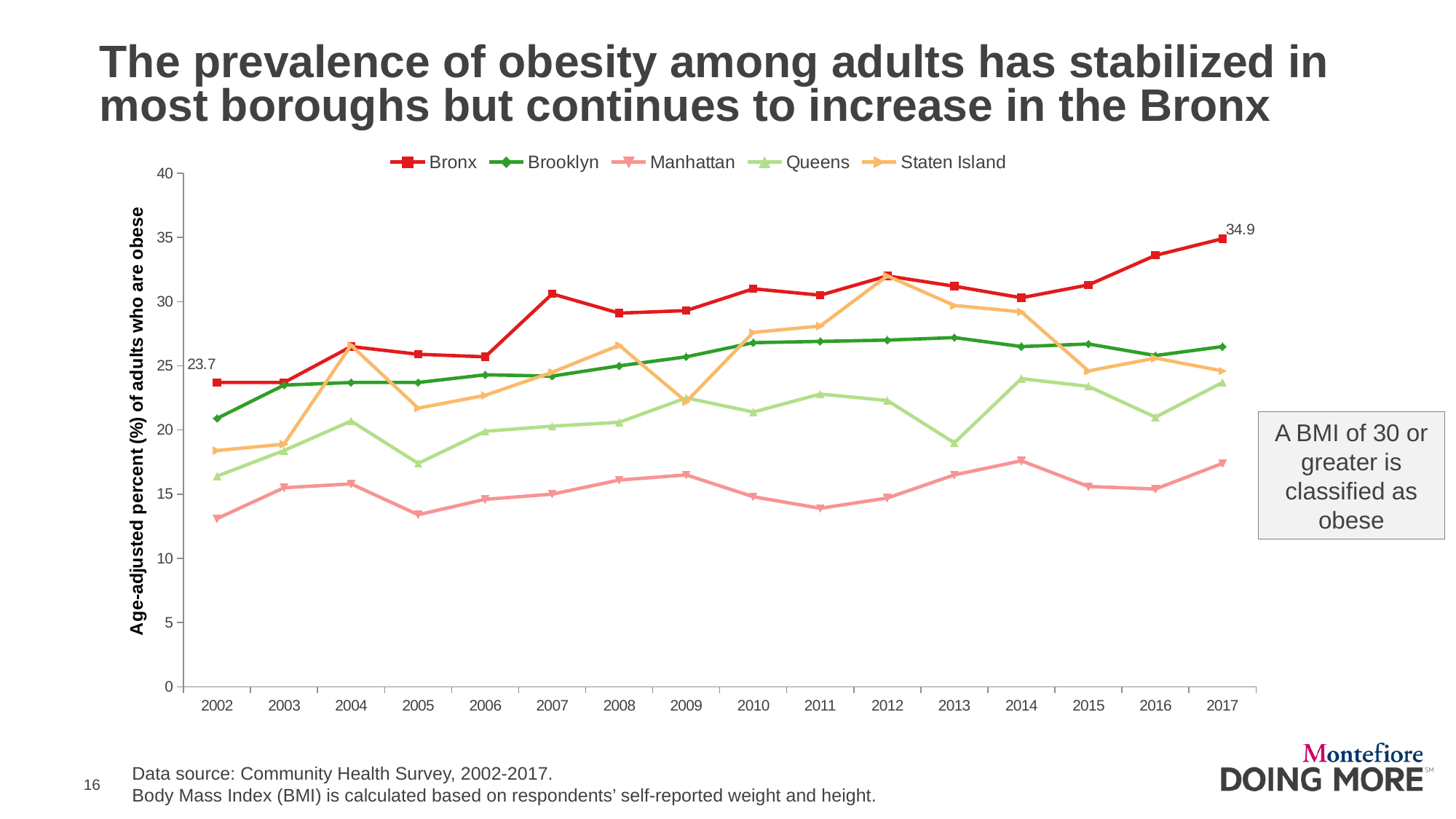
How many series does the legend list? 5 Does the Bronx line generally rise or fall from 2002 to 2017? Rise How many years are shown on the x axis? 16 In 2012, which is larger: the value for Queens or the value for Staten Island? Staten Island By how much did the Bronx value increase from 2002 to 2017? 11.2 What is the value for the Bronx in 2017? 34.9 What is the title of the y axis? Age-adjusted percent (%) of adults who are obese Which borough has the lowest value in 2017? Manhattan Which borough has the highest value in 2017? Bronx What is the value for the Bronx in 2002? 23.7 Is the value for Manhattan in 2017 greater or less than 20? less What kind of chart is shown on the slide? Line chart